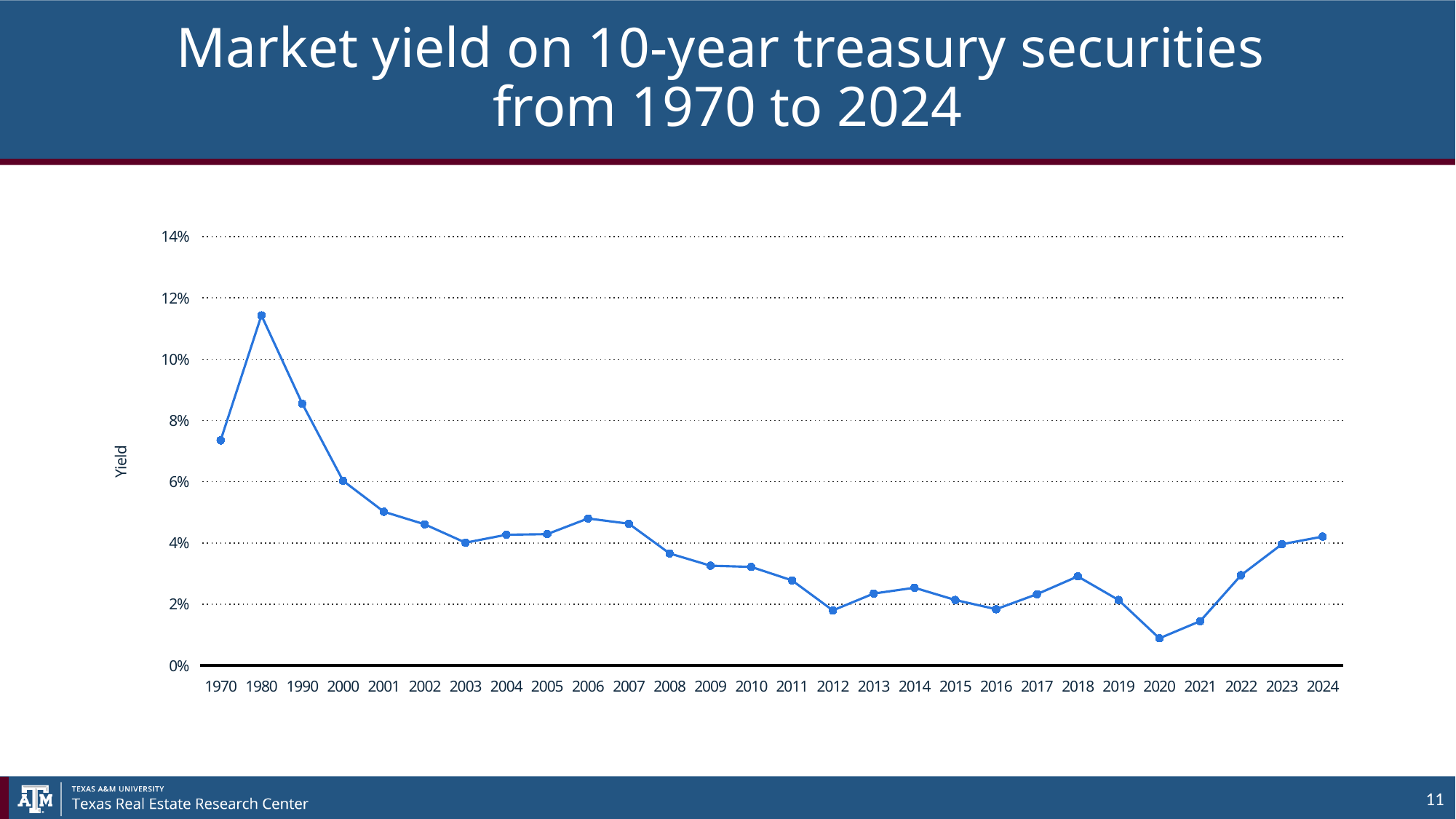
Is the value for 1970 greater or less than 6%? greater What is the label on the vertical axis of the chart? Yield Which year has the lowest market yield on the chart? 2020 Does the yield rise or fall from 2020 to 2024? Rise How many data points are plotted on the chart? 28 Is the value for 2008 greater or less than 4%? less Which year has the highest market yield on the chart? 1980 Is the value for 1980 greater or less than 10%? greater Which year has the larger yield, 2018 or 2020? 2018 Which year has the larger yield, 1990 or 2000? 1990 What kind of chart is shown on the slide? Line chart